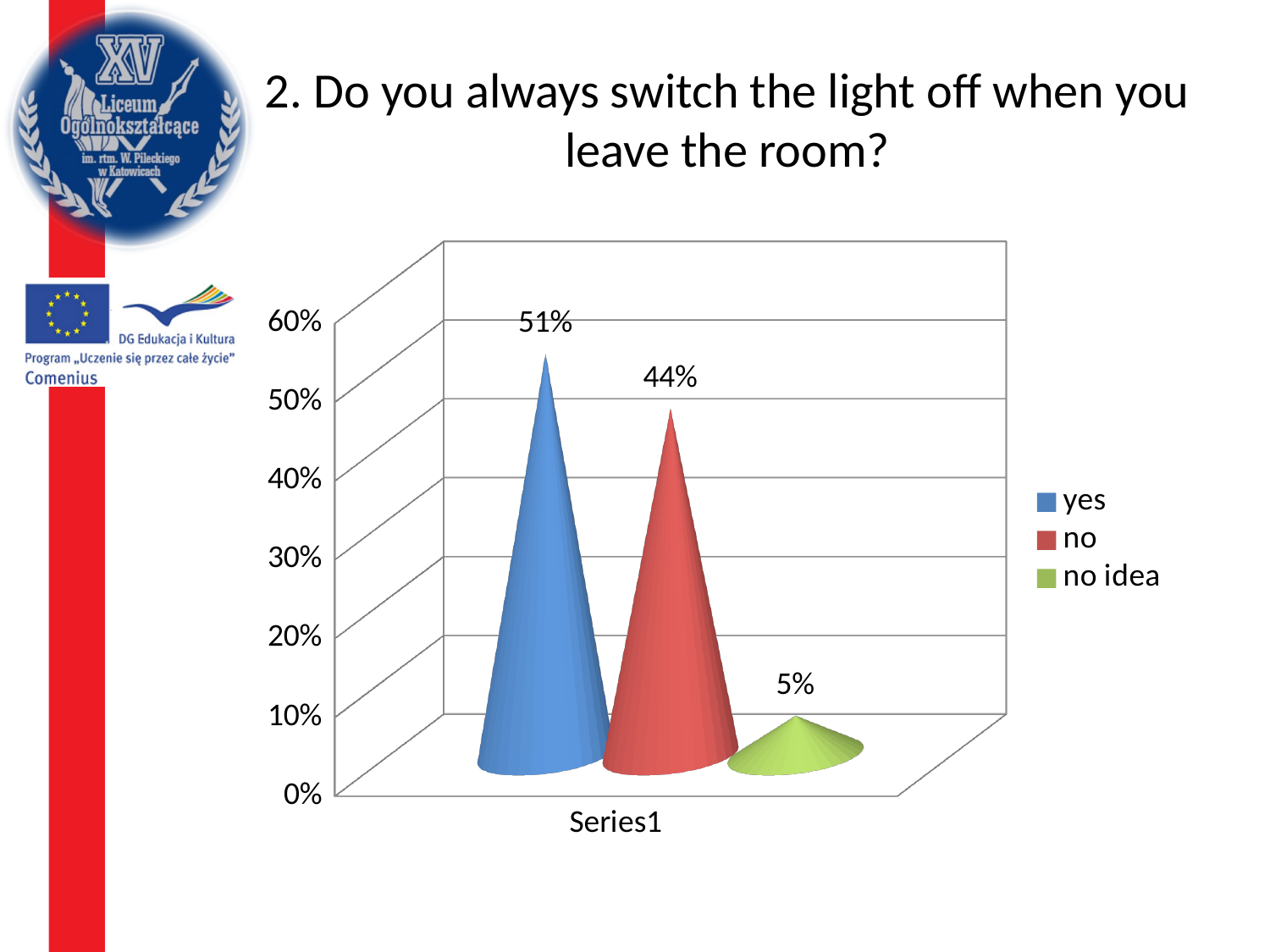
What is the title of the chart's question on the slide? 2. Do you always switch the light off when you leave the room? What percentage of respondents answered "yes"? 51% Which answer has the lowest percentage? no idea What is the difference between the "no" and "no idea" percentages? 39% How many series does the legend list? 3 What percentage of respondents answered "no idea"? 5% What percentage of respondents answered "no"? 44% What is the difference between the "yes" and "no" percentages? 7% Which is larger, the value for "yes" or the value for "no"? yes Is the value for "no" greater or less than 40%? greater What kind of chart is shown on the slide? bar chart Which answer has the highest percentage? yes